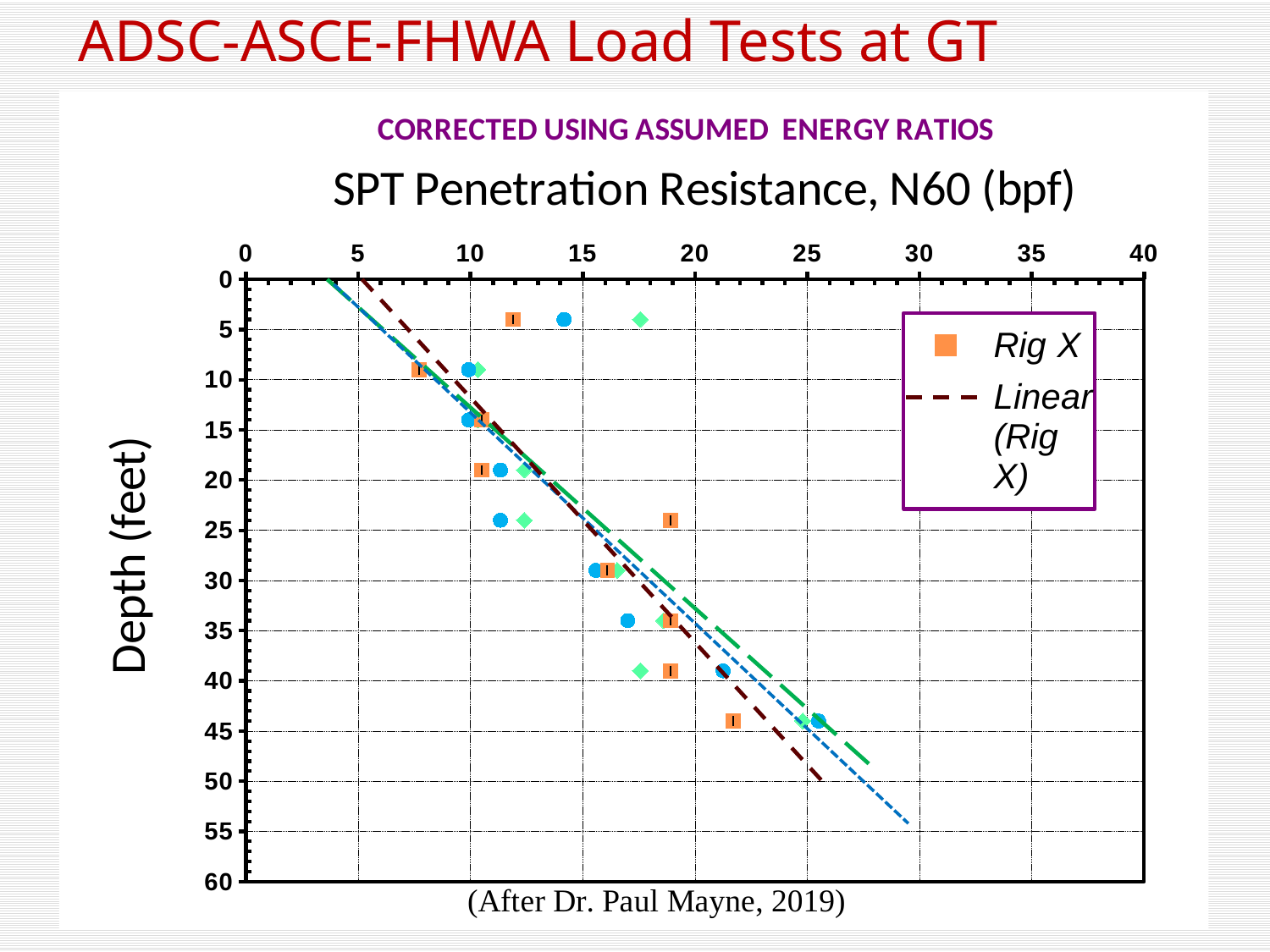
At which depth does Rig X have its lowest N60 value? 9 feet Does the Rig X N60 value generally increase or decrease as depth increases? increase Is the Rig X value at a depth of 24 feet greater or less than 15? greater At which depth does Rig X have its highest N60 value? 44 feet Is the Rig X value at a depth of 44 feet greater or less than 20? greater Is the Rig X value at a depth of 9 feet greater or less than 10? less What is the label of the chart's vertical axis? Depth (feet) What is the title of the chart's horizontal axis? SPT Penetration Resistance, N60 (bpf) How many entries does the chart legend list? 2 How many Rig X data points are plotted on the chart? 9 What kind of chart is shown on the slide? Scatter chart